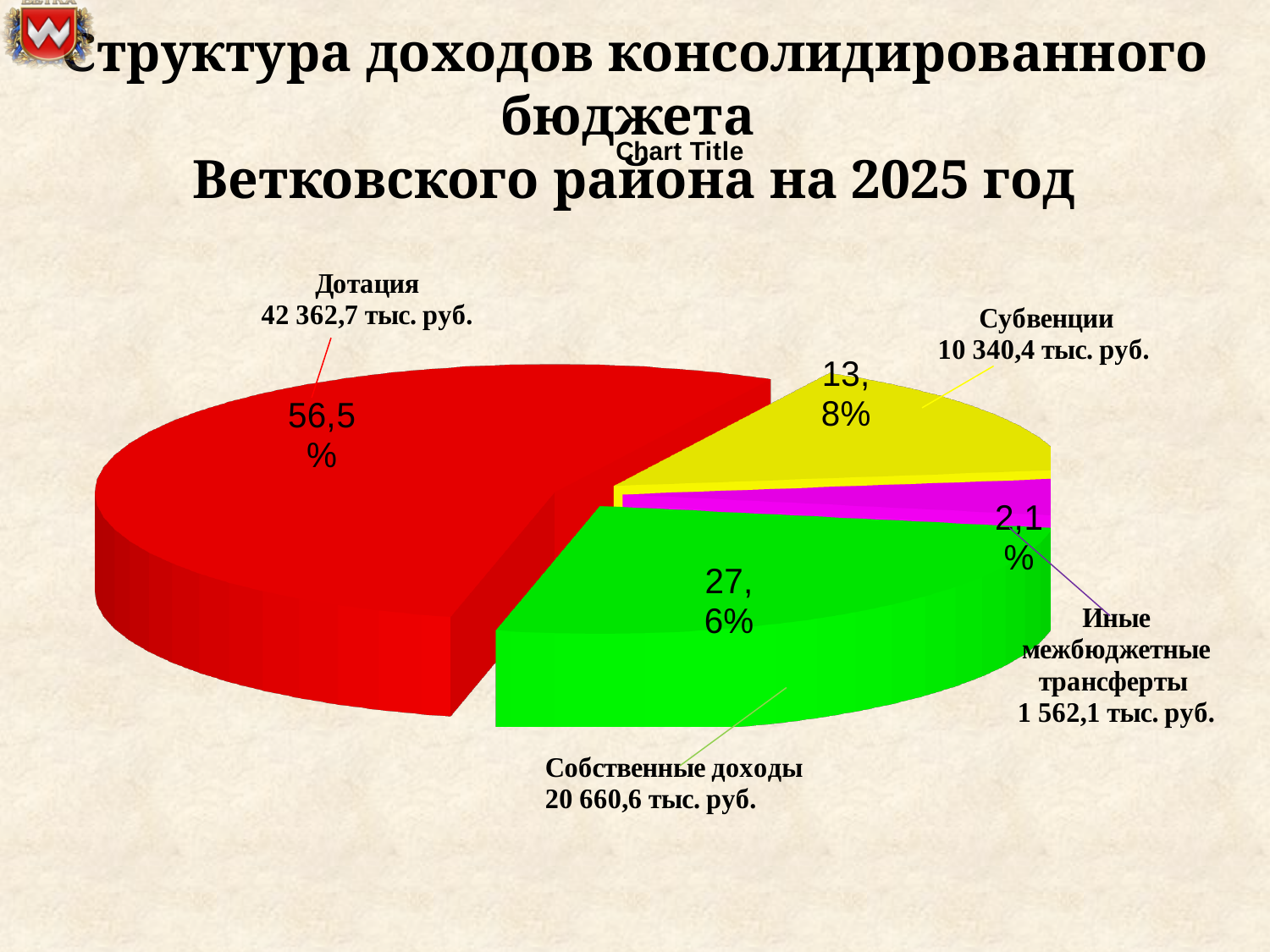
Which category has the largest slice of the pie? Дотация What is the value shown for Иные межбюджетные трансферты? 1 562,1 тыс. руб. What share of the pie does Дотация take? 56,5% What is the value shown for Субвенции? 10 340,4 тыс. руб. Which category has the smallest slice of the pie? Иные межбюджетные трансферты What kind of chart is shown on the slide? pie chart How many slices does the pie chart have? 4 What is the value shown for Собственные доходы? 20 660,6 тыс. руб. Which is larger, Субвенции or Собственные доходы? Собственные доходы What share of the pie does Собственные доходы take? 27,6% What is the value shown for Дотация? 42 362,7 тыс. руб. What colour is the slice for Субвенции? yellow